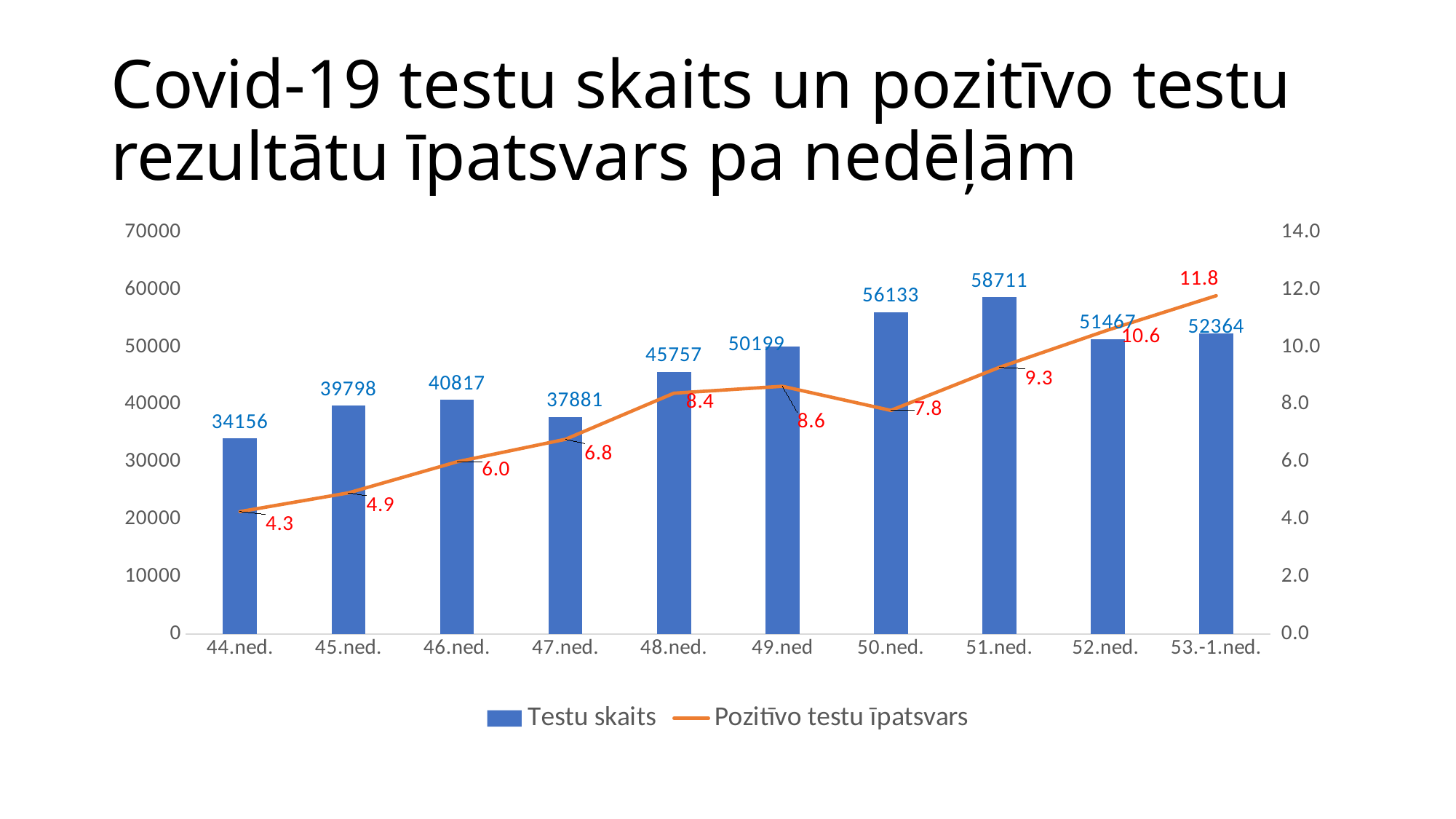
Is the Testu skaits for 48.ned. greater or less than 40000? greater What is the value of Testu skaits for 44.ned.? 34156 Which week has the highest Testu skaits? 51.ned. Which is larger, the Testu skaits for 52.ned. or for 53.-1.ned.? 53.-1.ned. Does Pozitīvo testu īpatsvars rise or fall from 50.ned. to 53.-1.ned.? rise Which week has the lowest Pozitīvo testu īpatsvars? 44.ned. What kind of chart is this? Combined bar and line chart How many weeks are shown on the x axis? 10 What is the difference in Testu skaits between 51.ned. and 50.ned.? 2578 What colour is the Pozitīvo testu īpatsvars line? Orange How many series does the legend list? 2 What is the value of Pozitīvo testu īpatsvars for 52.ned.? 10.6